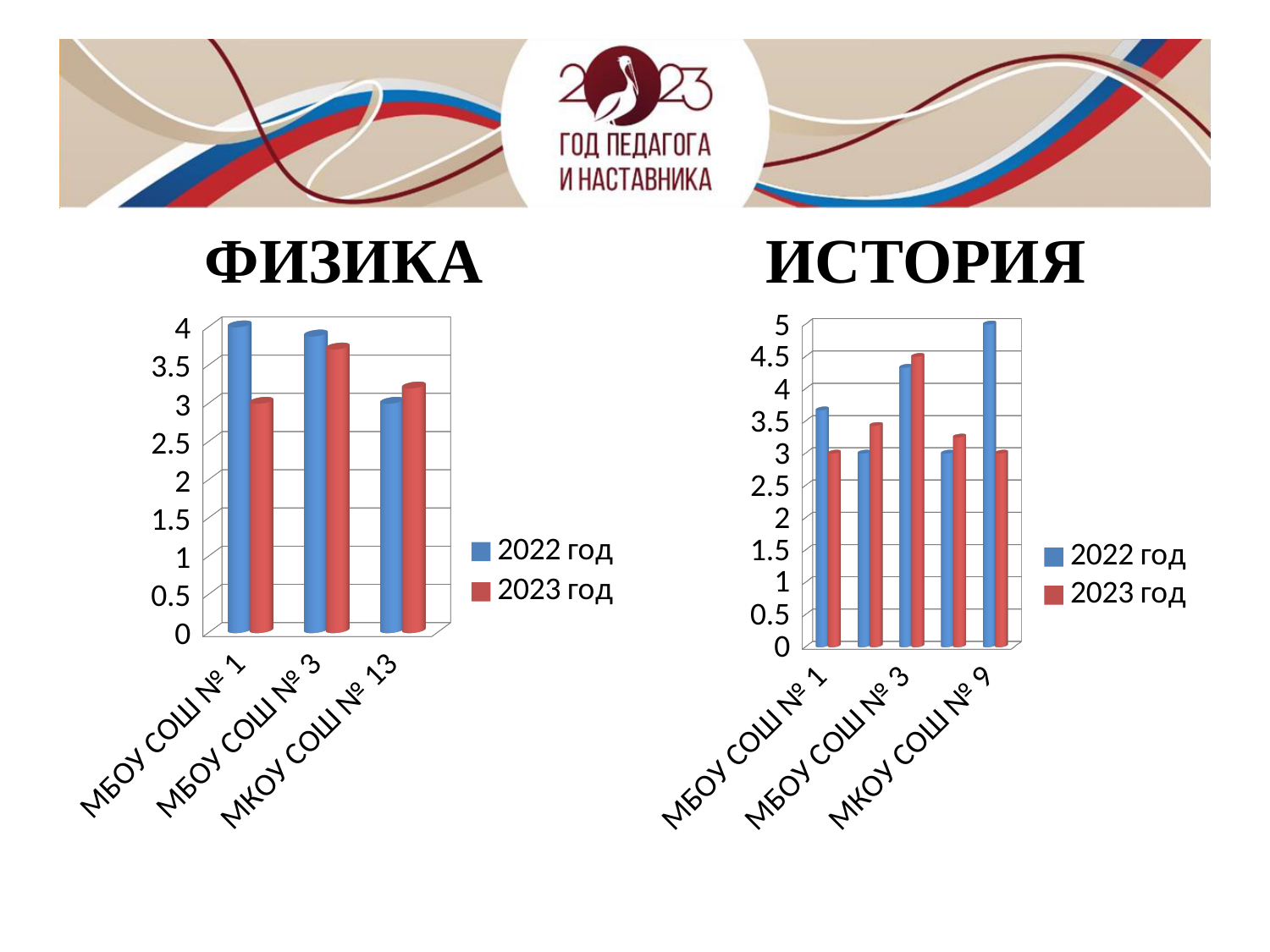
What kind of chart is the ФИЗИКА chart? bar chart In the ИСТОРИЯ chart, what is the value for МКОУ СОШ № 9 in 2022 год? 5 What are the two legend entries of the ФИЗИКА chart? 2022 год and 2023 год In the ИСТОРИЯ chart, for МБОУ СОШ № 3, which is larger: the 2022 год value or the 2023 год value? 2023 год In the ФИЗИКА chart, what is the value for МБОУ СОШ № 1 in 2022 год? 4 In the ФИЗИКА chart, for МБОУ СОШ № 1, which is larger: the 2022 год value or the 2023 год value? 2022 год In the ИСТОРИЯ chart, is the 2022 год value for МБОУ СОШ № 1 greater or less than 3.5? greater In the ФИЗИКА chart, which school has the highest value for 2022 год? МБОУ СОШ № 1 In the ФИЗИКА chart, is the 2023 год value for МБОУ СОШ № 3 greater or less than 3.5? greater How many schools are shown on the x axis of the ФИЗИКА chart? 3 How many series does the legend of the ИСТОРИЯ chart list? 2